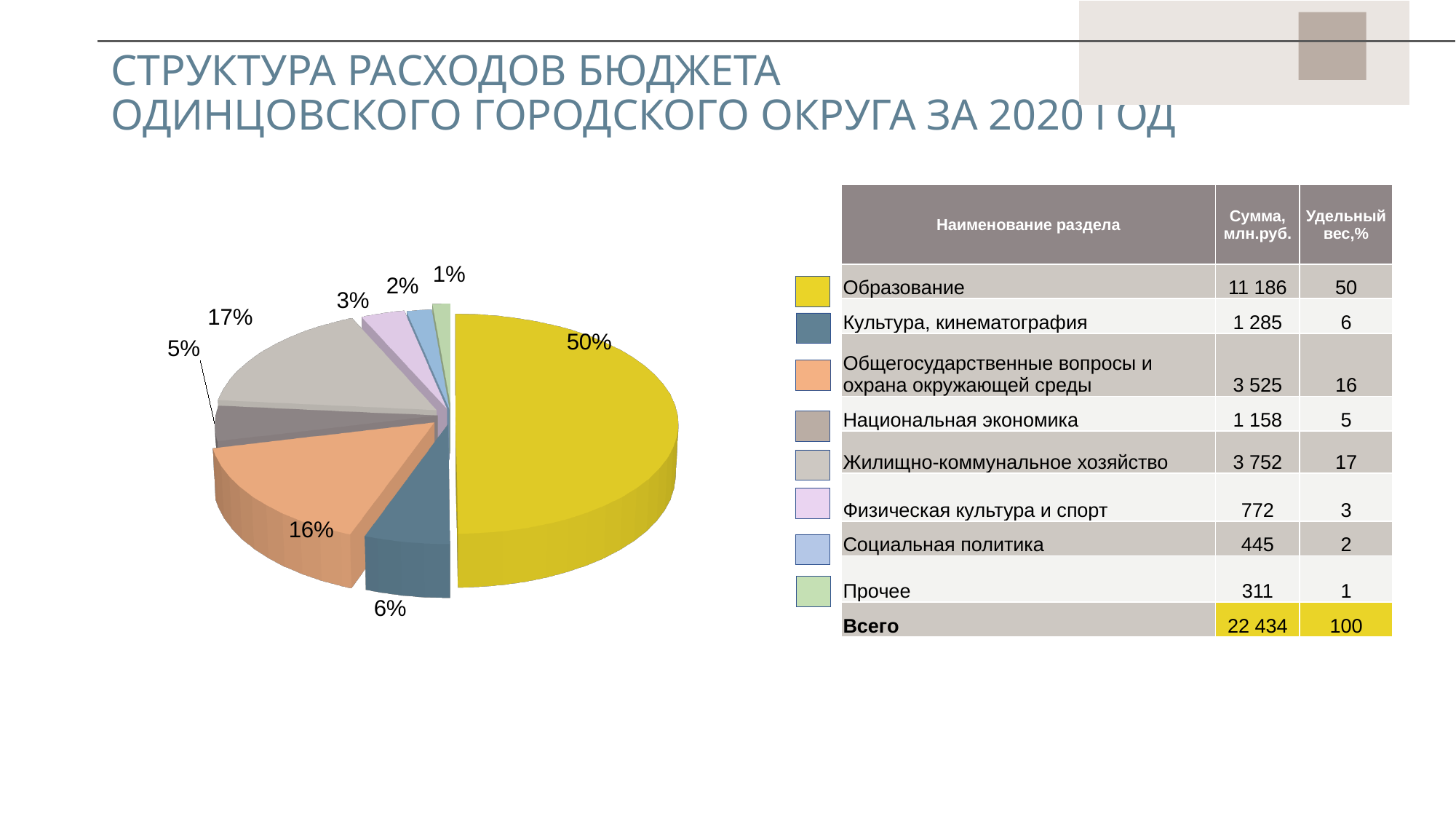
Which category has the largest slice of the pie? Образование What share of the pie does the Культура, кинематография slice represent? 6% What share of the pie does the Образование slice (yellow) represent? 50% What share of the pie does the Общегосударственные вопросы и охрана окружающей среды slice represent? 16% Which slice is larger: Национальная экономика or Физическая культура и спорт? Национальная экономика Which category has the smallest slice of the pie? Прочее How many slices does the pie chart have? 8 What is the difference in percentage points between the Образование slice and the Жилищно-коммунальное хозяйство slice? 33 What colour is the slice representing Социальная политика? light blue What kind of chart is shown on the slide? pie chart